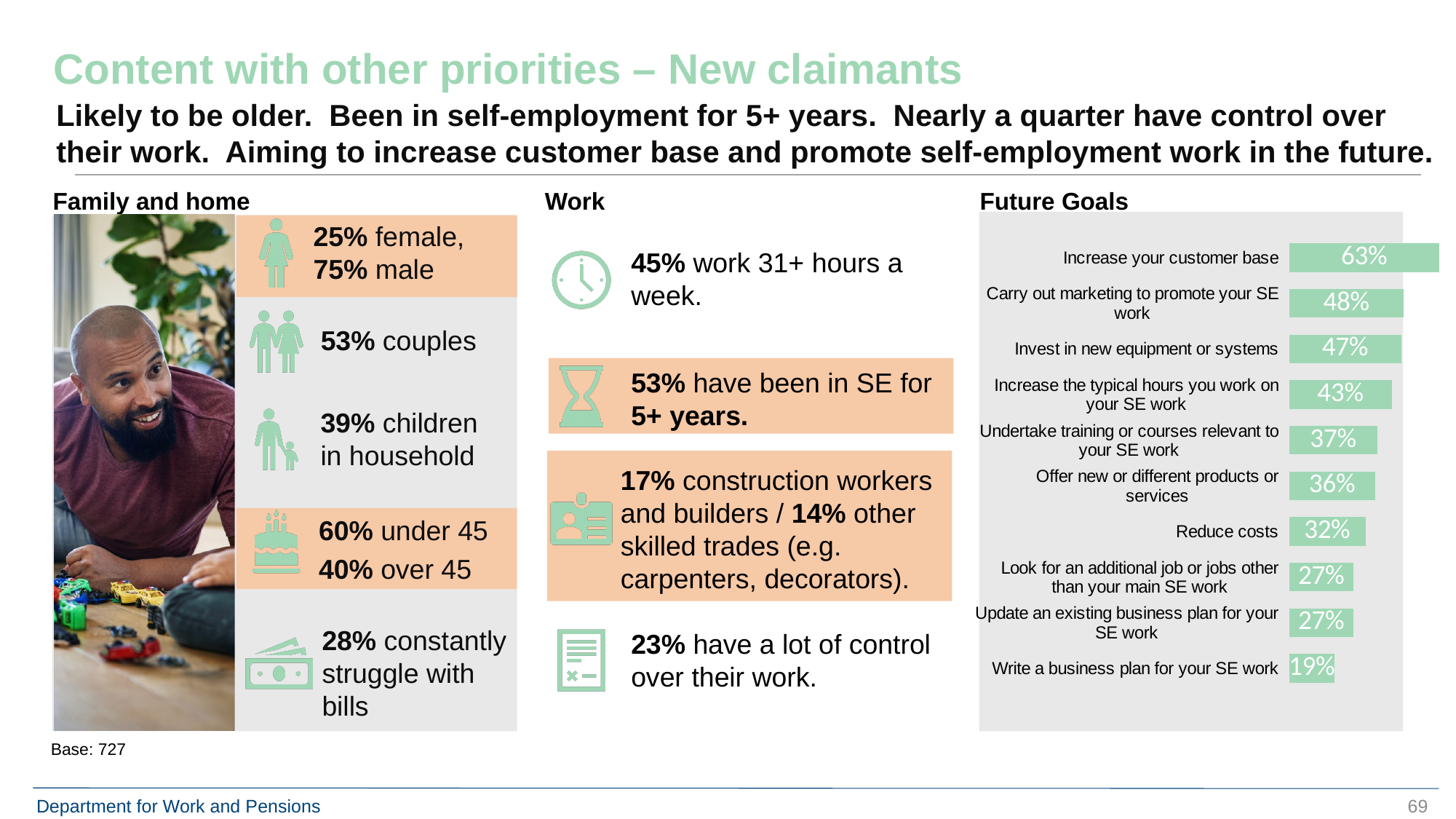
In the Future Goals chart, which two goals share the same value of 27%? Look for an additional job or jobs other than your main SE work; Update an existing business plan for your SE work In the Future Goals chart, what is the value for 'Invest in new equipment or systems'? 47% In the Future Goals chart, what is the difference between 'Carry out marketing to promote your SE work' and 'Reduce costs'? 16% In the Future Goals chart, what is the value for 'Reduce costs'? 32% In the Future Goals chart, which goal has the highest percentage? Increase your customer base How many goals are listed in the Future Goals chart? 10 In the Future Goals chart, what is the difference between 'Increase your customer base' and 'Write a business plan for your SE work'? 44% In the Future Goals chart, what percentage plan to undertake training or courses relevant to their SE work? 37% In the Future Goals chart, what percentage of new claimants aim to increase their customer base? 63% What type of chart is the Future Goals chart? Bar chart In the Future Goals chart, which is larger: 'Offer new or different products or services' or 'Reduce costs'? Offer new or different products or services In the Future Goals chart, which goal has the lowest percentage? Write a business plan for your SE work